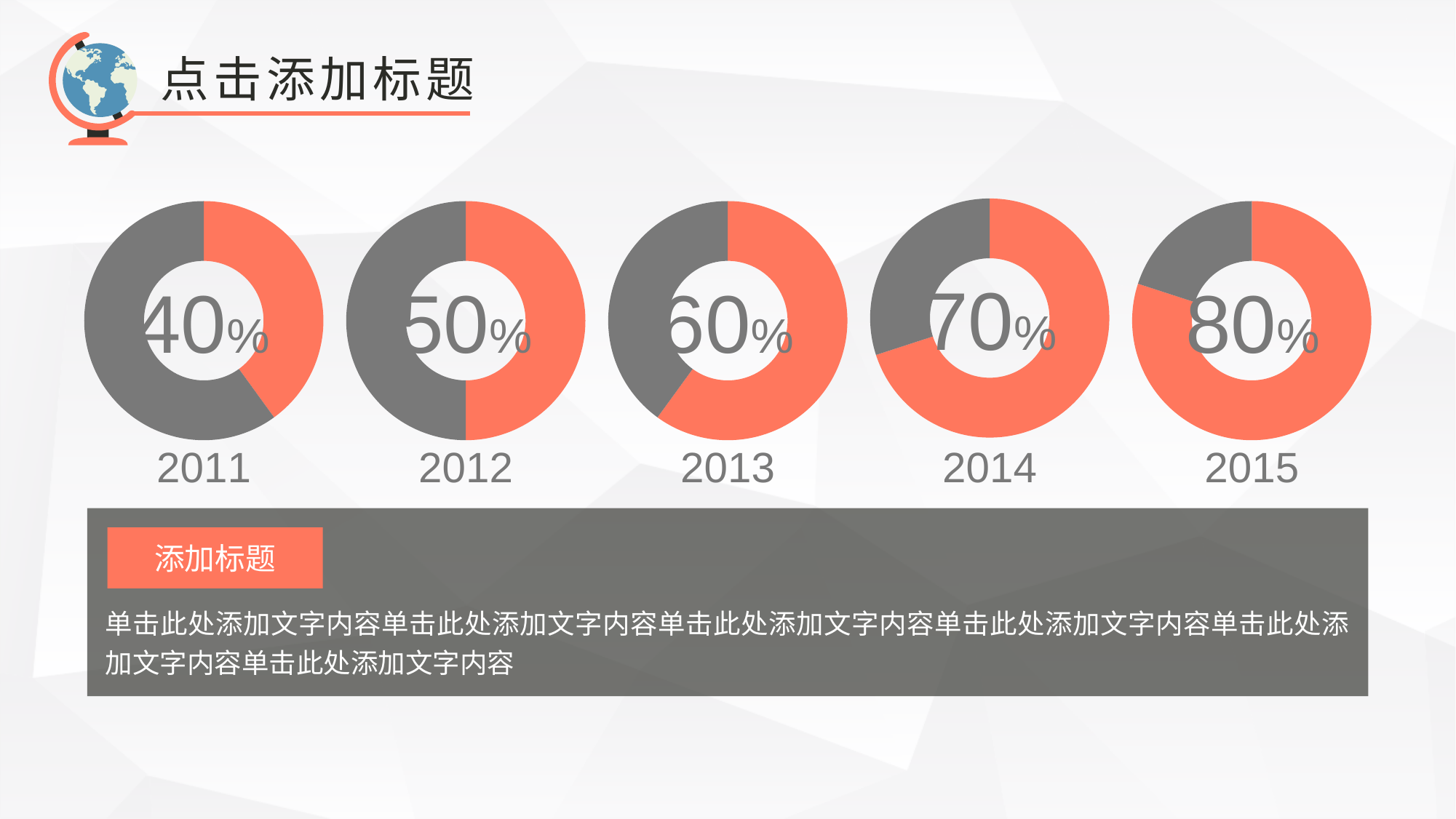
Which year's donut chart shows the lowest percentage? 2011 How many donut charts are shown on the slide? 5 Which year's donut chart shows the highest percentage? 2015 Which shows a larger percentage, the 2012 donut chart or the 2013 donut chart? 2013 In the 2012 donut chart, what share of the ring is orange? 50% What kind of chart is used to display the yearly percentages on this slide? Donut chart What percentage is shown in the donut chart labelled 2011? 40% Do the percentages rise or fall from 2011 to 2015? Rise What percentage is shown in the donut chart labelled 2015? 80% What percentage is shown in the donut chart labelled 2013? 60% What colour represents the percentage value in each donut chart? Orange What is the difference between the percentage shown for 2014 and the percentage shown for 2012? 20%